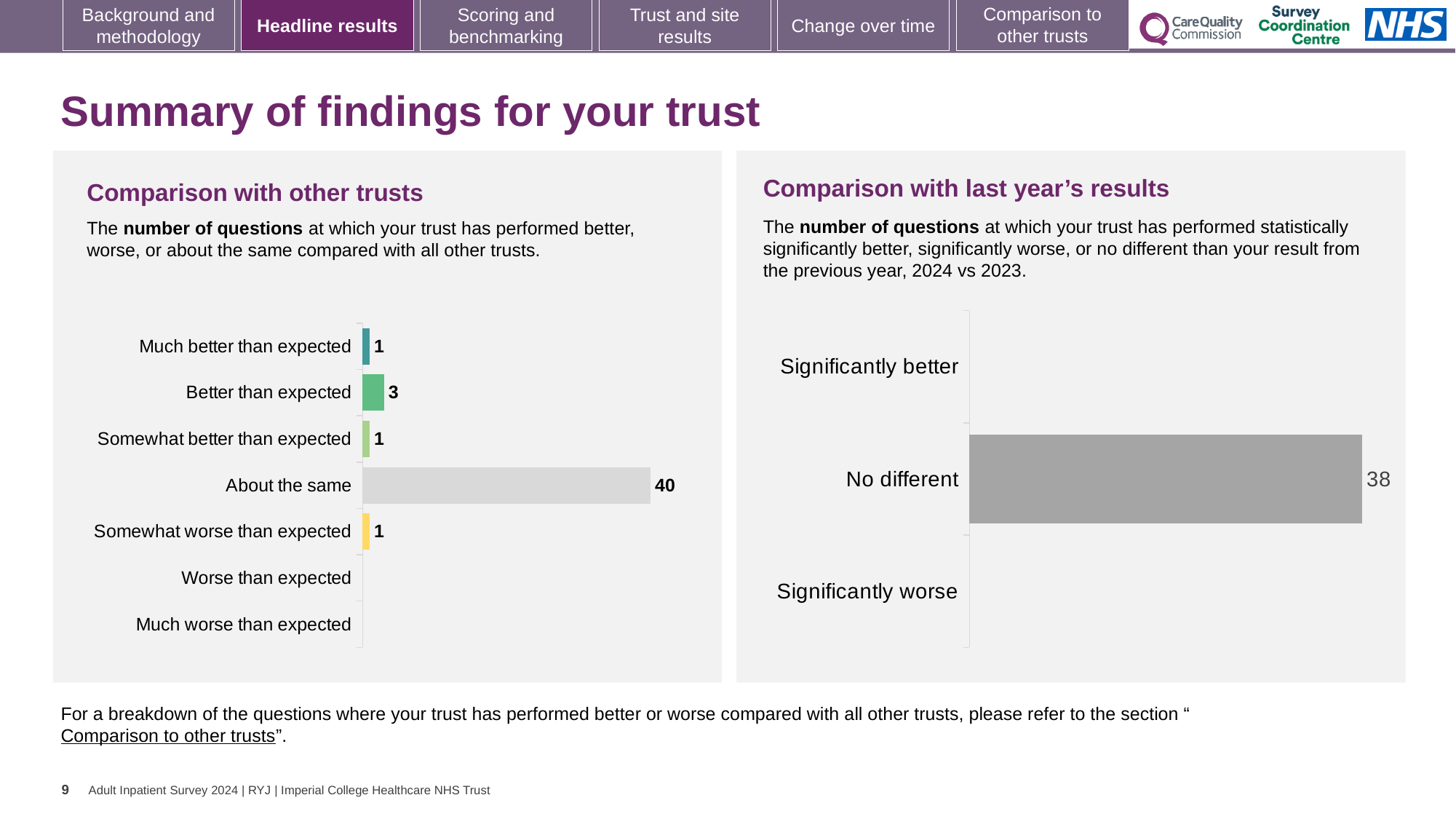
In the 'Comparison with other trusts' chart, which is larger: 'Better than expected' or 'Much better than expected'? Better than expected In the 'Comparison with last year's results' chart, which category has the highest value? No different How many categories are shown in the 'Comparison with last year's results' chart? 3 In the 'Comparison with other trusts' chart, which category has the highest value? About the same In the 'Comparison with other trusts' chart, what colour is the 'About the same' bar? Grey How many categories are shown in the 'Comparison with other trusts' chart? 7 In the 'Comparison with other trusts' chart, what is the difference between 'About the same' and 'Better than expected'? 37 In the 'Comparison with other trusts' chart, how many questions were 'About the same'? 40 In the 'Comparison with last year's results' chart, what is the value for 'No different'? 38 What type of chart is the 'Comparison with other trusts' chart? Bar chart In the 'Comparison with other trusts' chart, what is the value for 'Somewhat worse than expected'? 1 In the 'Comparison with other trusts' chart, what is the value for 'Better than expected'? 3